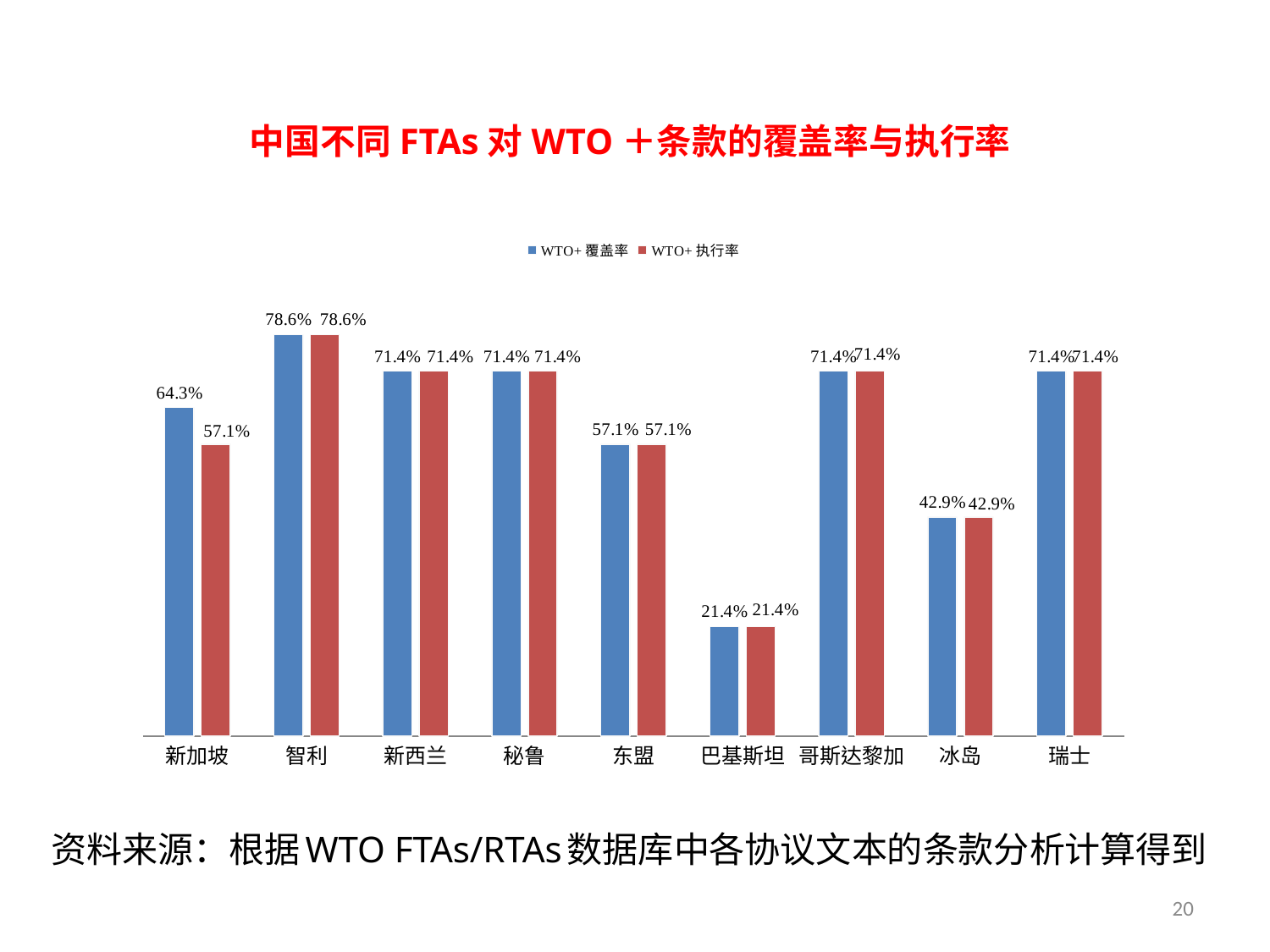
Which category has the lowest WTO+ 执行率? 巴基斯坦 What is the difference between the WTO+ 覆盖率 and WTO+ 执行率 values for 新加坡? 7.2% What is the WTO+ 覆盖率 value for 新加坡? 64.3% What colour represents the WTO+ 执行率 series? Red How many series does the legend list? 2 Which category has the highest WTO+ 覆盖率? 智利 Which is larger, the WTO+ 覆盖率 for 冰岛 or the WTO+ 覆盖率 for 东盟? 东盟 What is the WTO+ 执行率 value for 巴基斯坦? 21.4% What is the WTO+ 覆盖率 value for 智利? 78.6% How many categories are shown on the x axis? 9 What is the WTO+ 执行率 value for 新加坡? 57.1% What kind of chart is shown on the slide? Bar chart